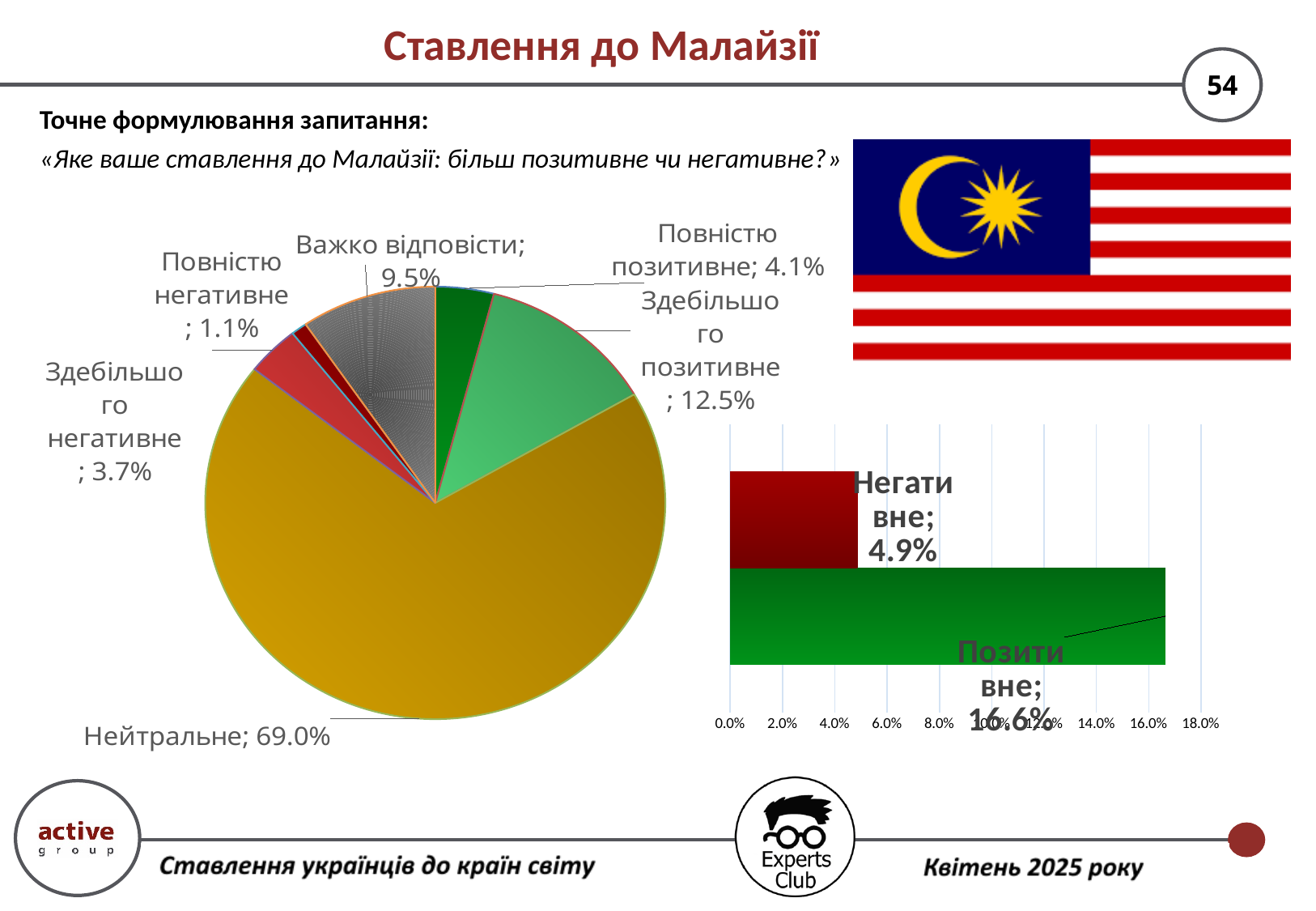
In the pie chart, what is the value for "Повністю негативне"? 1.1% In the pie chart, what share is labelled for "Нейтральне"? 69.0% In the bar chart on the right, what is the value for "Позитивне"? 16.6% In the pie chart, which is larger: "Здебільшого негативне" or "Повністю позитивне"? Повністю позитивне In the bar chart on the right, what is the difference between "Позитивне" and "Негативне"? 11.7% In the pie chart, what is the value for "Здебільшого позитивне"? 12.5% In the pie chart, which category has the largest slice? Нейтральне In the pie chart, how many slices are there? 6 In the pie chart, which category has the smallest slice? Повністю негативне In the pie chart, what is the difference between "Здебільшого позитивне" and "Повністю позитивне"? 8.4% What type of chart is shown on the right side of the slide? Bar chart In the pie chart, what is the value for "Важко відповісти"? 9.5%